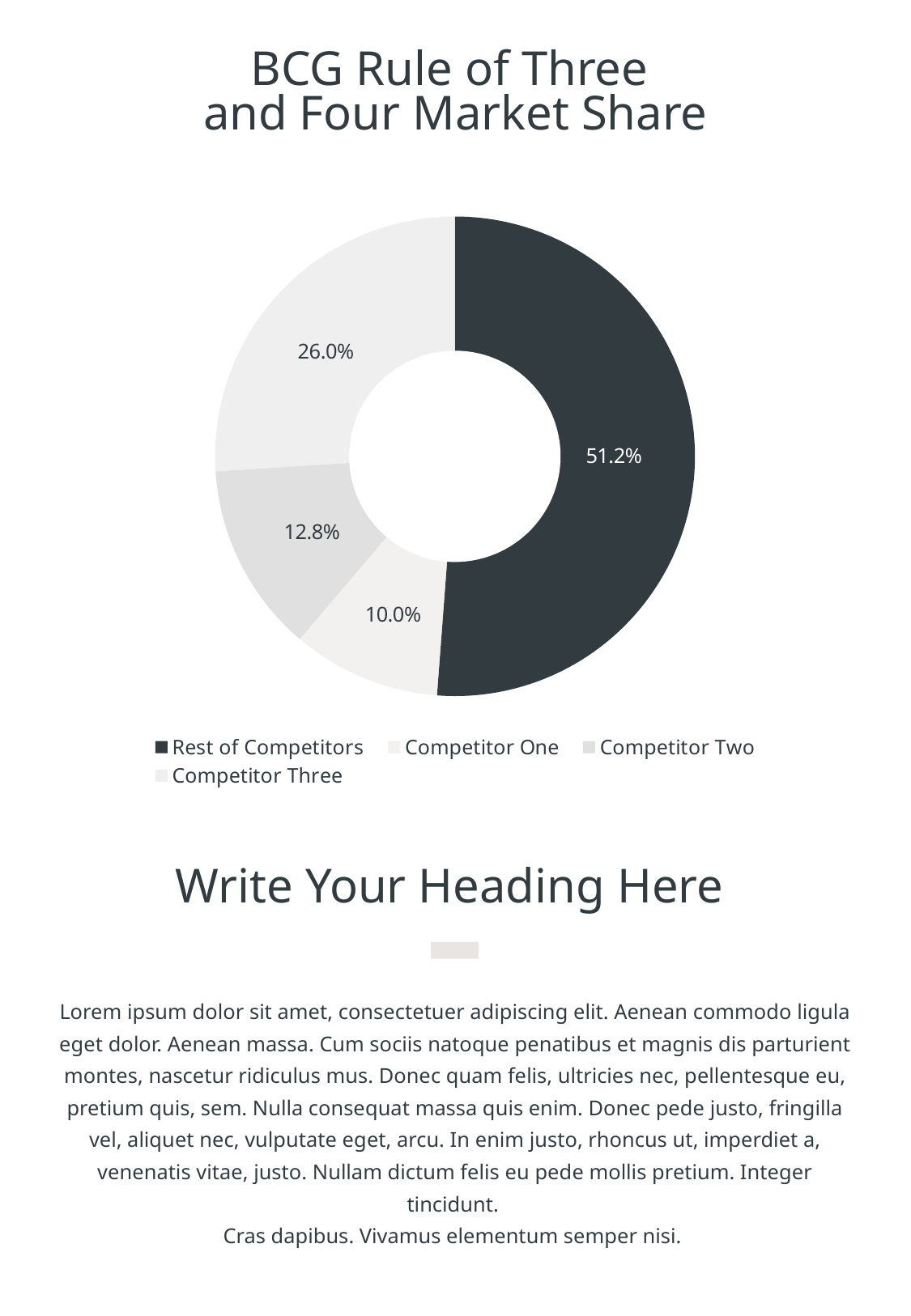
How many entries does the legend list? 4 What share of the market does Competitor Three hold? 26.0% What is the difference in percentage points between Competitor Three and Competitor Two? 13.2 What share of the market does Competitor Two hold? 12.8% How many slices does the chart have? 4 Which category has the smallest share of the chart? Competitor One What share of the market does Rest of Competitors hold? 51.2% What kind of chart is shown on the slide? Doughnut chart Which is larger, the share for Competitor Two or the share for Competitor One? Competitor Two What is the title of the chart? BCG Rule of Three and Four Market Share Which category has the largest share of the chart? Rest of Competitors What share of the market does Competitor One hold? 10.0%